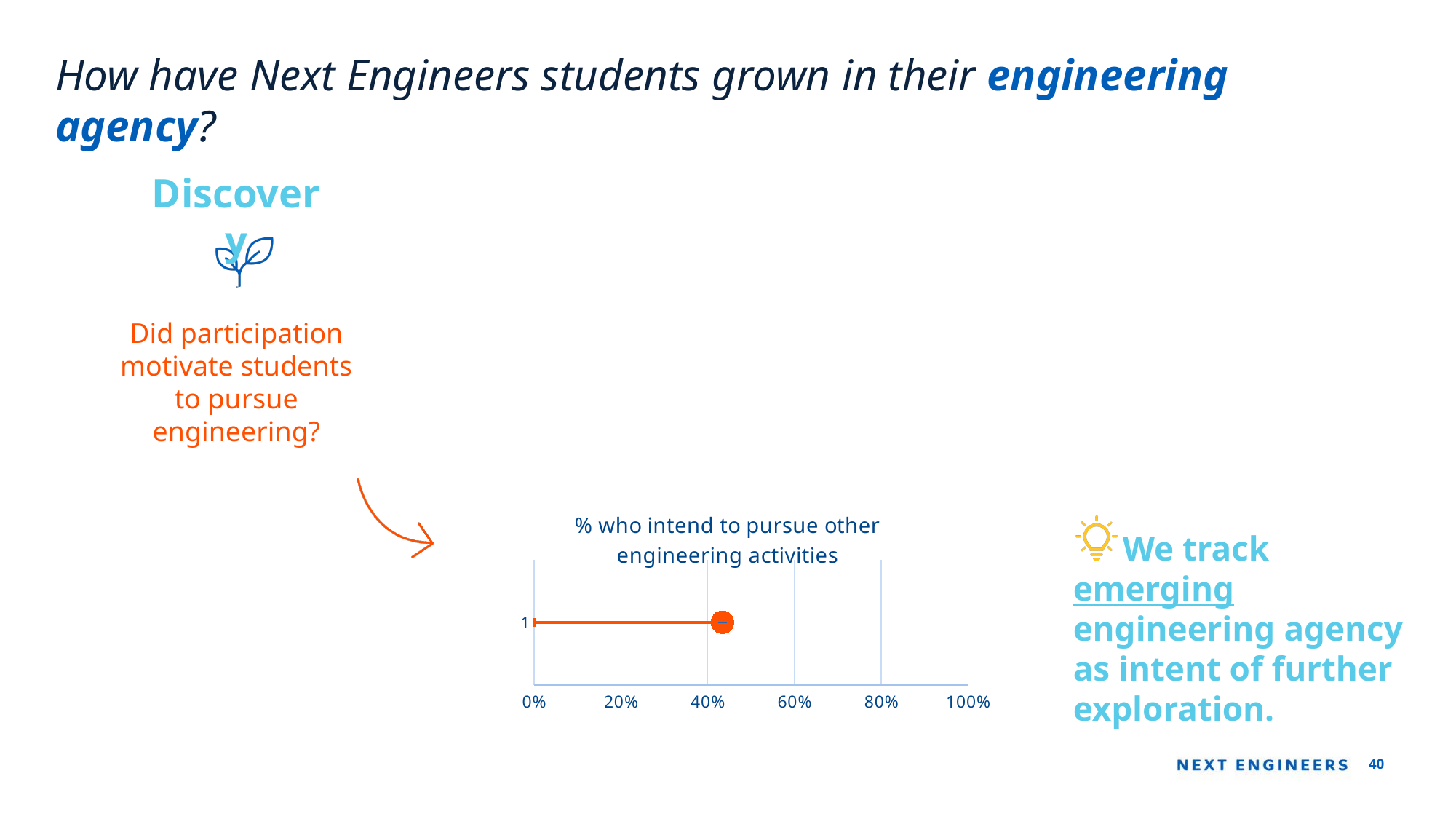
What is the label of the single category plotted in the chart? 1 How many categories are plotted in the chart? 1 Is the value for category 1 in the chart greater or less than 80%? less Is the value for category 1 in the chart greater or less than 60%? less What is the highest value shown on the chart's horizontal axis? 100% What is the title of the chart on the slide? % who intend to pursue other engineering activities Is the value for category 1 in the chart greater or less than 40%? greater